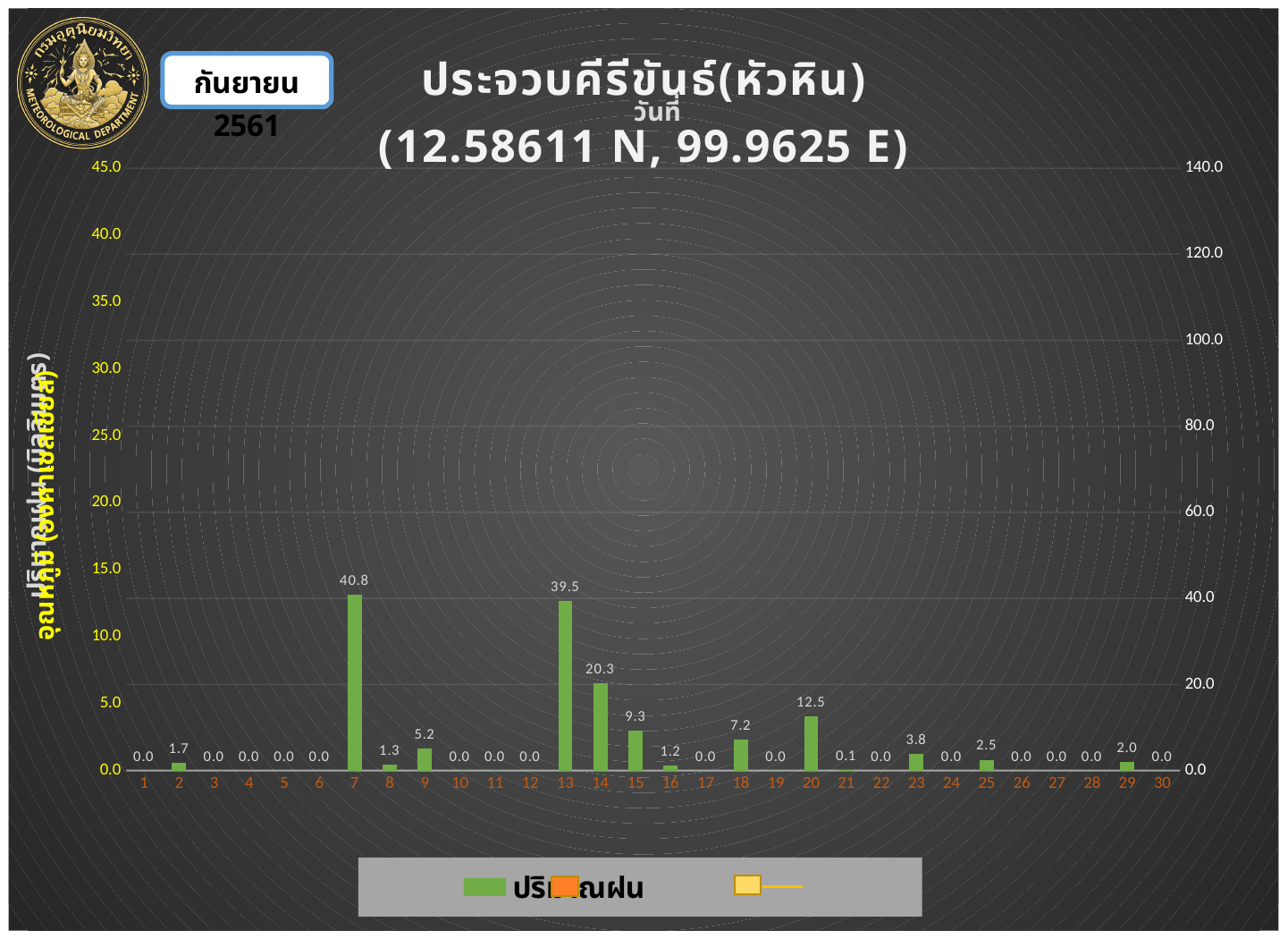
What is the label of the green series in the legend? ปริมาณฝน Is the value for day 13 greater or less than 20.0 on the right axis? greater What is the rainfall value for day 7? 40.8 What is the rainfall value for day 20? 12.5 What is the rainfall value for day 14? 20.3 What is the difference between the rainfall values for day 7 and day 13? 1.3 What is the difference between the rainfall values for day 14 and day 15? 11.0 What kind of chart is shown on the slide? bar chart Which has a larger rainfall value, day 14 or day 15? day 14 How many days are shown on the x axis? 30 Which day has the highest rainfall value? 7 What is the rainfall value for day 13? 39.5